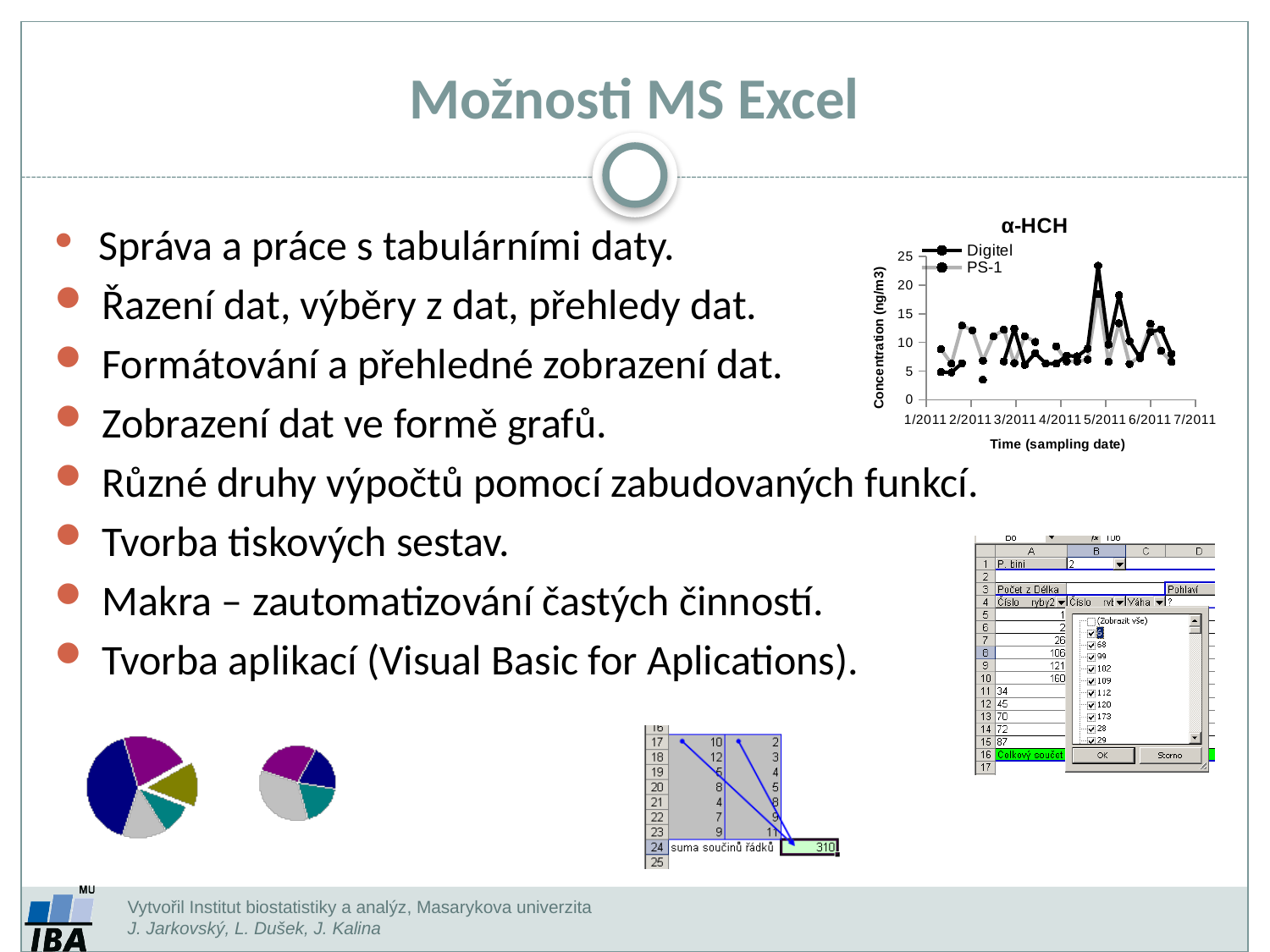
What is the y-axis title of the α-HCH chart? Concentration (ng/m3) What kind of charts are the two small charts at the bottom left of the slide? pie charts In the α-HCH chart, is the highest peak of the PS-1 series greater or less than 15? greater What is the last date label on the x axis of the α-HCH chart? 7/2011 What kind of chart is the α-HCH chart? line chart In the α-HCH chart, is the highest peak of the Digitel series greater or less than 20? greater What is the x-axis title of the α-HCH chart? Time (sampling date) What is the first date label on the x axis of the α-HCH chart? 1/2011 What are the two series named in the legend of the α-HCH chart? Digitel and PS-1 How many series does the legend of the α-HCH chart list? 2 What is the title of the line chart on the right of the slide? α-HCH What is the maximum value shown on the y axis of the α-HCH chart? 25